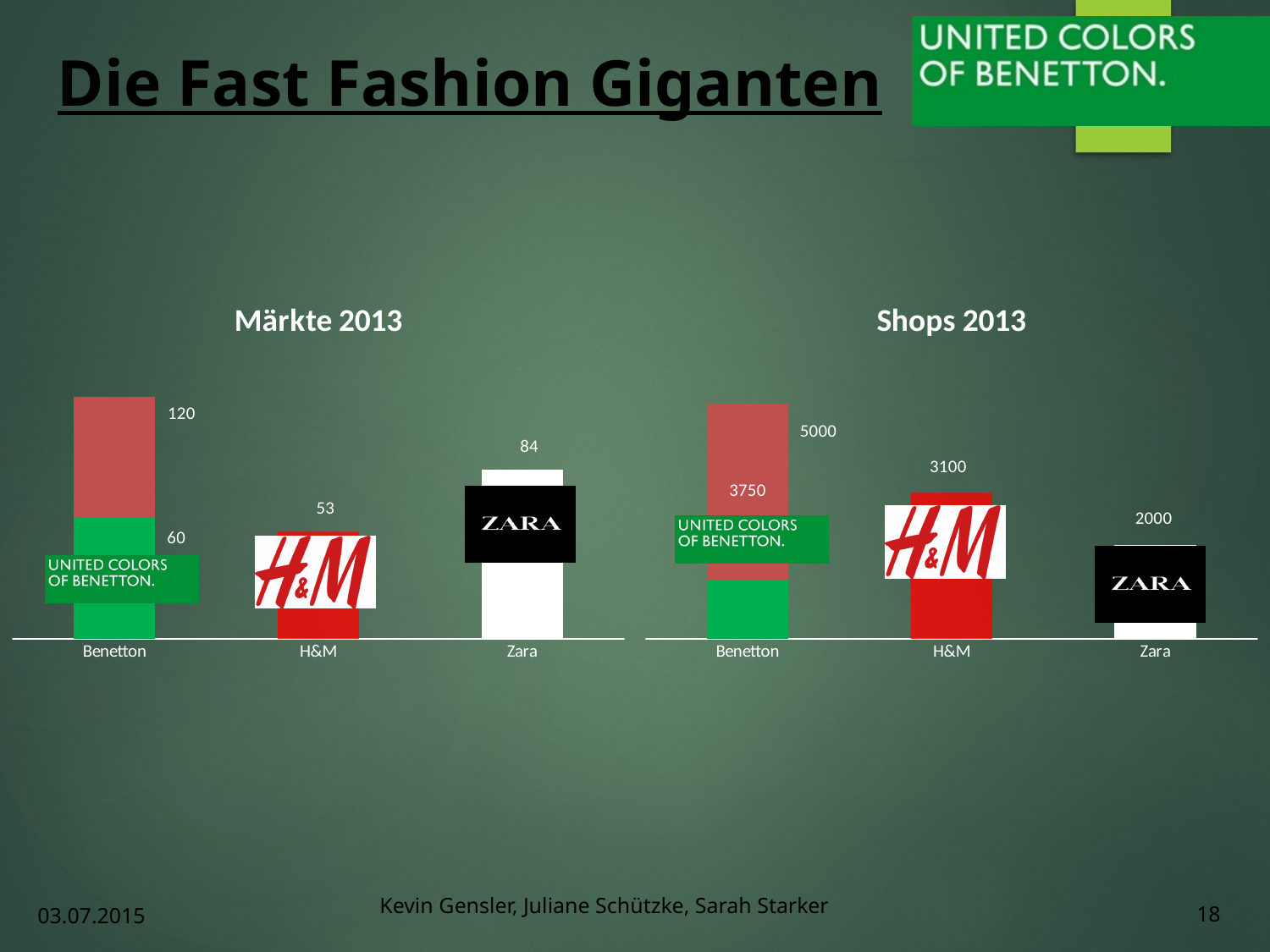
In the Shops 2013 chart, which is larger, the value for H&M or the value for Zara? H&M In the Märkte 2013 chart, what is the difference between the values for Zara and H&M? 31 In the Märkte 2013 chart, what is the value for H&M? 53 In the Shops 2013 chart, what is the value for H&M? 3100 What is the title of the chart on the left side of the slide? Märkte 2013 What kind of chart is the Shops 2013 chart? Bar chart In the Märkte 2013 chart, what is the value for Zara? 84 In the Märkte 2013 chart, which is larger, the value for H&M or the value for Zara? Zara How many categories are shown on the x axis of the Märkte 2013 chart? 3 In the Shops 2013 chart, what is the value for Zara? 2000 In the Shops 2013 chart, what is the difference between the values for H&M and Zara? 1100